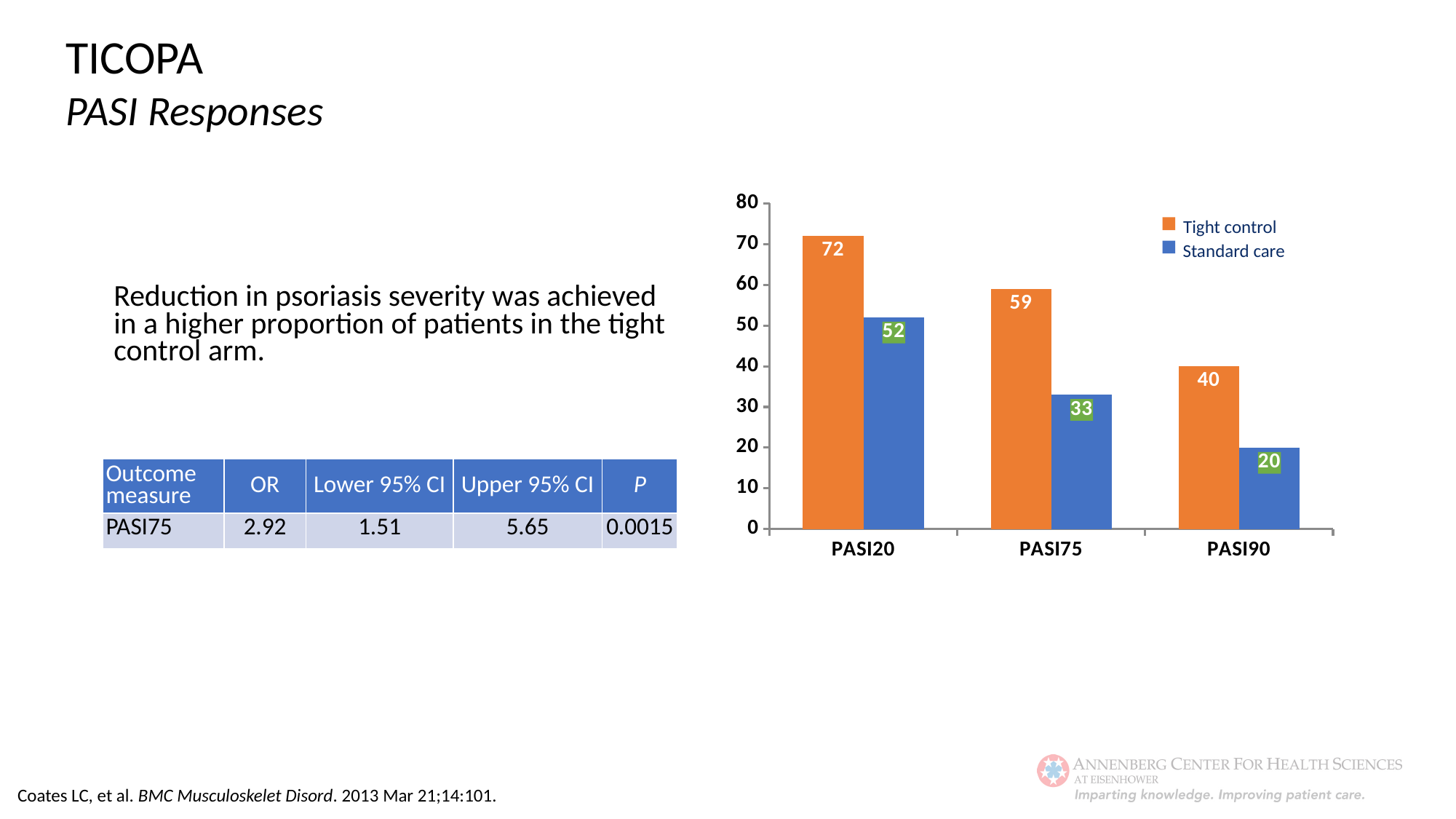
What is the Standard care value for PASI75? 33 Which is larger for PASI90, the Tight control value or the Standard care value? Tight control What is the difference between the Tight control and Standard care values for PASI75? 26 What is the Tight control value for PASI20? 72 How many series does the legend list? 2 What is the difference between the Tight control values for PASI20 and PASI90? 32 What kind of chart is shown on the slide? bar chart Which category has the highest Tight control value? PASI20 What is the Standard care value for PASI90? 20 How many categories are shown on the x axis? 3 Which category has the lowest Standard care value? PASI90 Is the Standard care value for PASI20 greater or less than 60? less